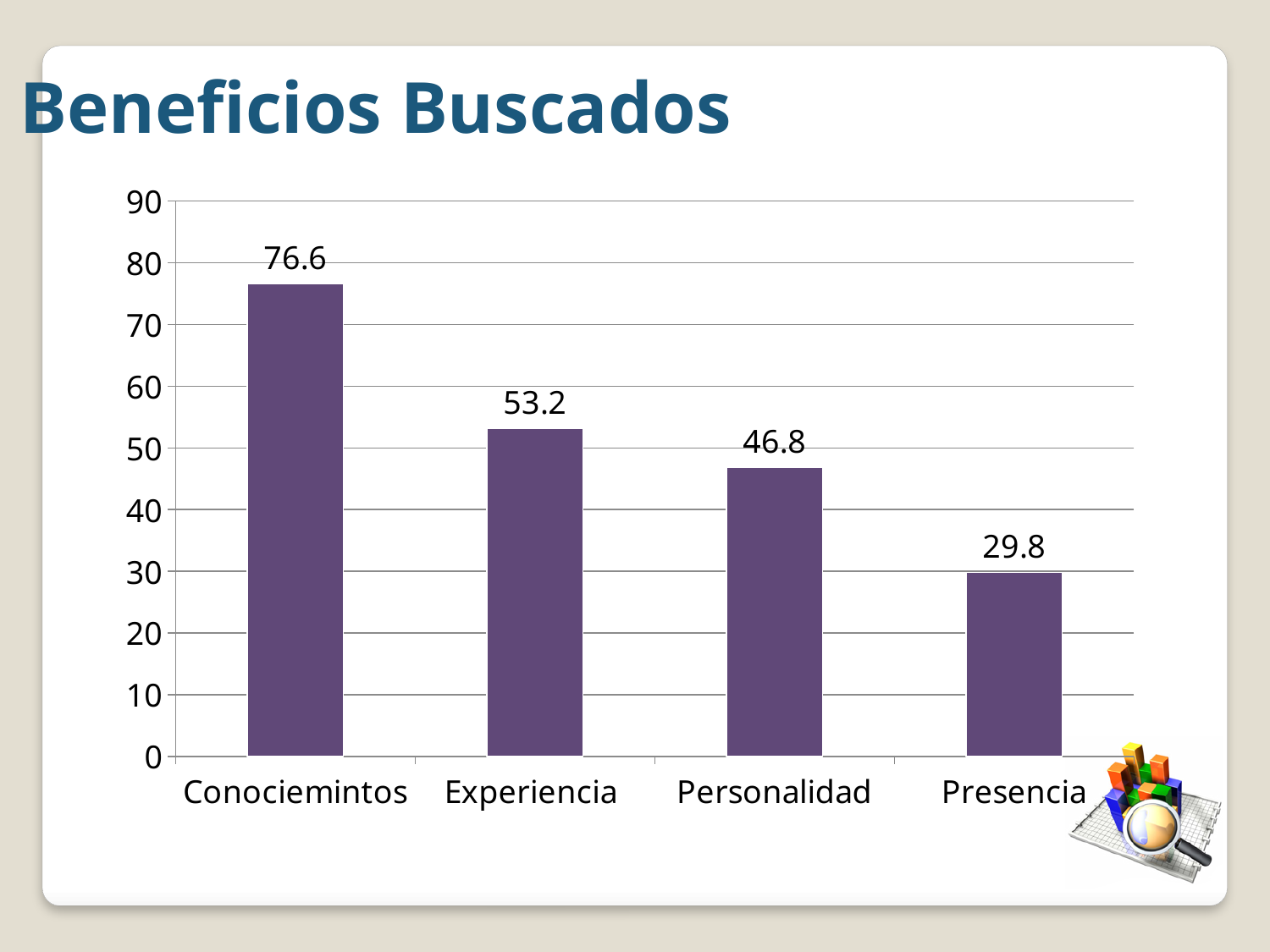
Do the values rise or fall from left to right along the x axis? Fall How many categories are shown on the x axis? 4 What is the value for Personalidad? 46.8 What kind of chart is shown on the slide? Bar chart What is the value for Presencia? 29.8 What is the difference between the values for Experiencia and Personalidad? 6.4 Which category has the highest value? Conociemintos Which category has the lowest value? Presencia What is the difference between the values for Conociemintos and Presencia? 46.8 Which is larger, the value for Experiencia or the value for Personalidad? Experiencia What is the value for Experiencia? 53.2 What is the value for Conociemintos? 76.6